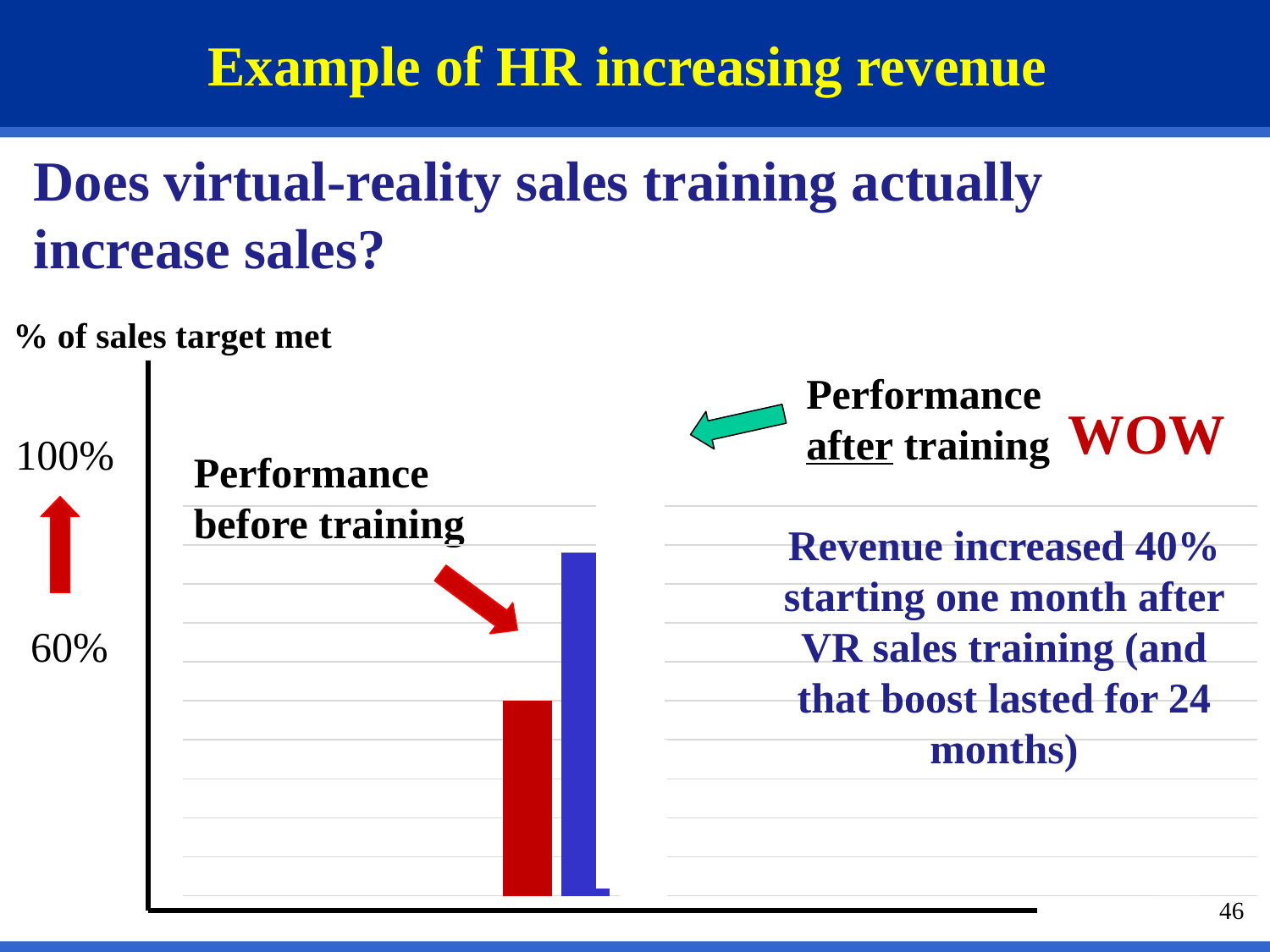
Which category has the highest value in the chart? Performance after training How many bars are plotted in the chart? 2 What kind of chart is shown on the slide? bar chart What colour is the bar for performance before training? red Is the value for performance before training greater or less than 100%? less Which bar is higher: performance before training or performance after training? Performance after training Is the value for performance after training greater or less than 60%? greater Is the value for performance after training greater or less than 100%? less Which category has the lowest value in the chart? Performance before training What does the vertical axis of the chart measure? % of sales target met Do the bar values rise or fall from before training to after training? rise